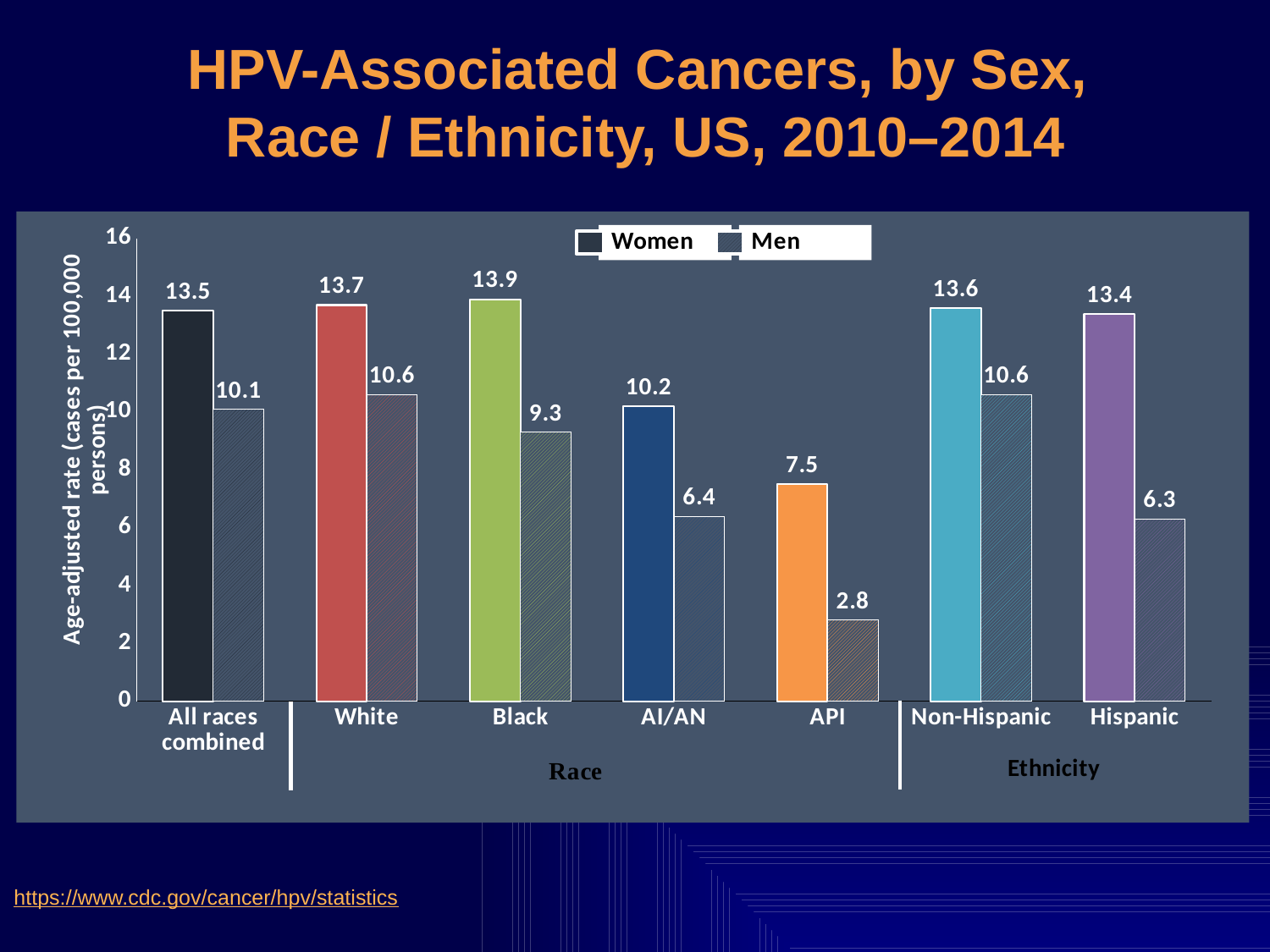
How many categories are shown on the x axis? 7 What is the age-adjusted rate for men in the API category? 2.8 What is the age-adjusted rate for women in the Black category? 13.9 Which is larger, the men's rate for AI/AN or the men's rate for Black? Black What kind of chart is shown on the slide? bar chart What is the difference between the women's rates for White and API? 6.2 What is the difference between the women's and men's rates for All races combined? 3.4 What is the age-adjusted rate for men in the Hispanic category? 6.3 How many series does the legend list? 2 Is the women's rate for API greater or less than 8? less Which category has the lowest rate for men? API Which category has the highest rate for women? Black